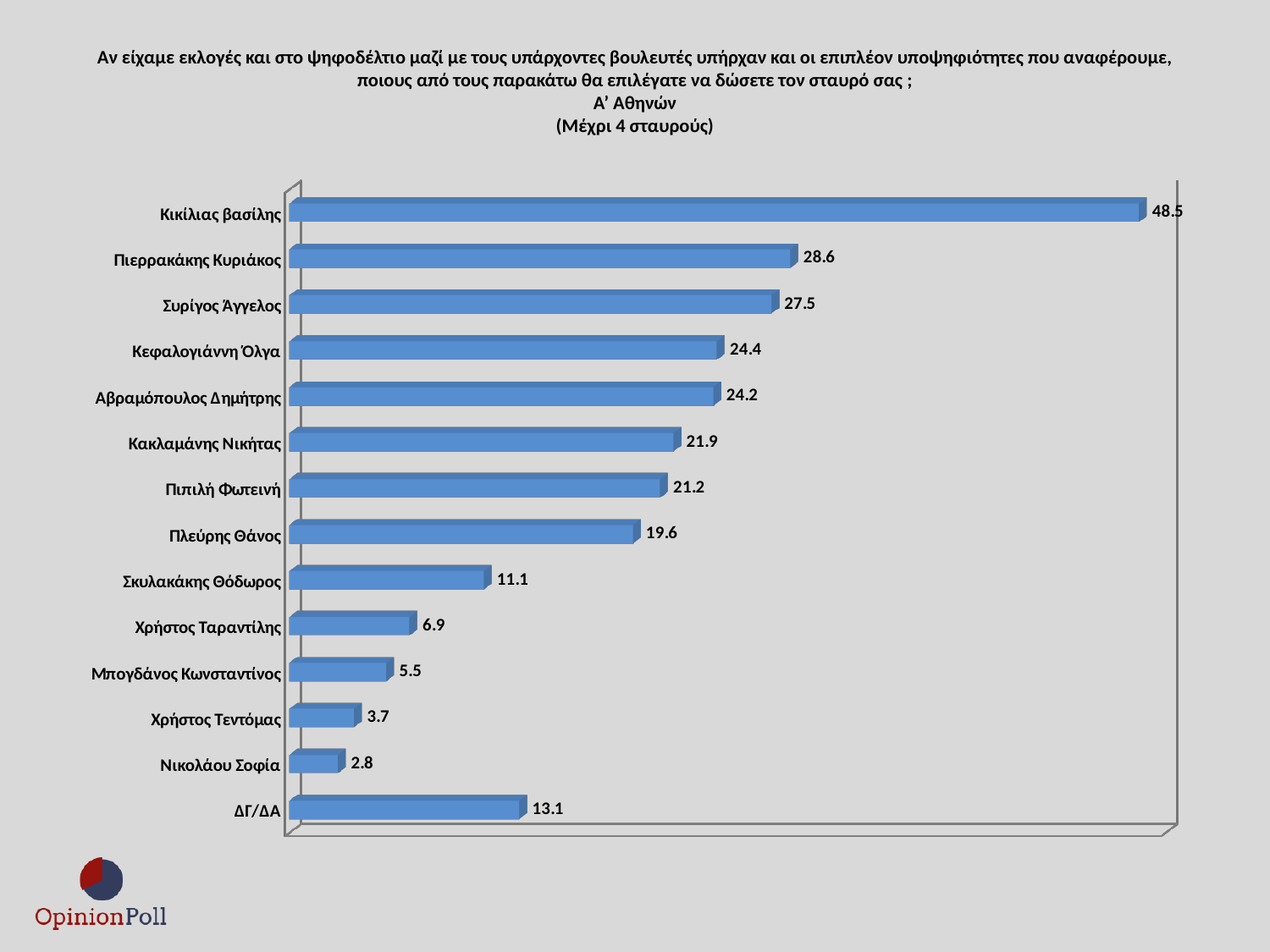
What value is shown for ΔΓ/ΔΑ? 13.1 What value is shown for Κικίλιας Βασίλης? 48.5 Which candidate has the highest value? Κικίλιας Βασίλης What value is shown for Πλεύρης Θάνος? 19.6 What value is shown for Χρήστος Τεντόμας? 3.7 How many categories are plotted in the chart? 14 What is the difference between the values for Πιερρακάκης Κυριάκος and Συρίγος Άγγελος? 1.1 What kind of chart is shown on the slide? Bar chart Which is larger, the value for Σκυλακάκης Θόδωρος or the value for ΔΓ/ΔΑ? ΔΓ/ΔΑ What is the difference between the values for Κικίλιας Βασίλης and Πιερρακάκης Κυριάκος? 19.9 Which electoral district is named in the chart title? Α' Αθηνών Which category has the lowest value? Νικολάου Σοφία